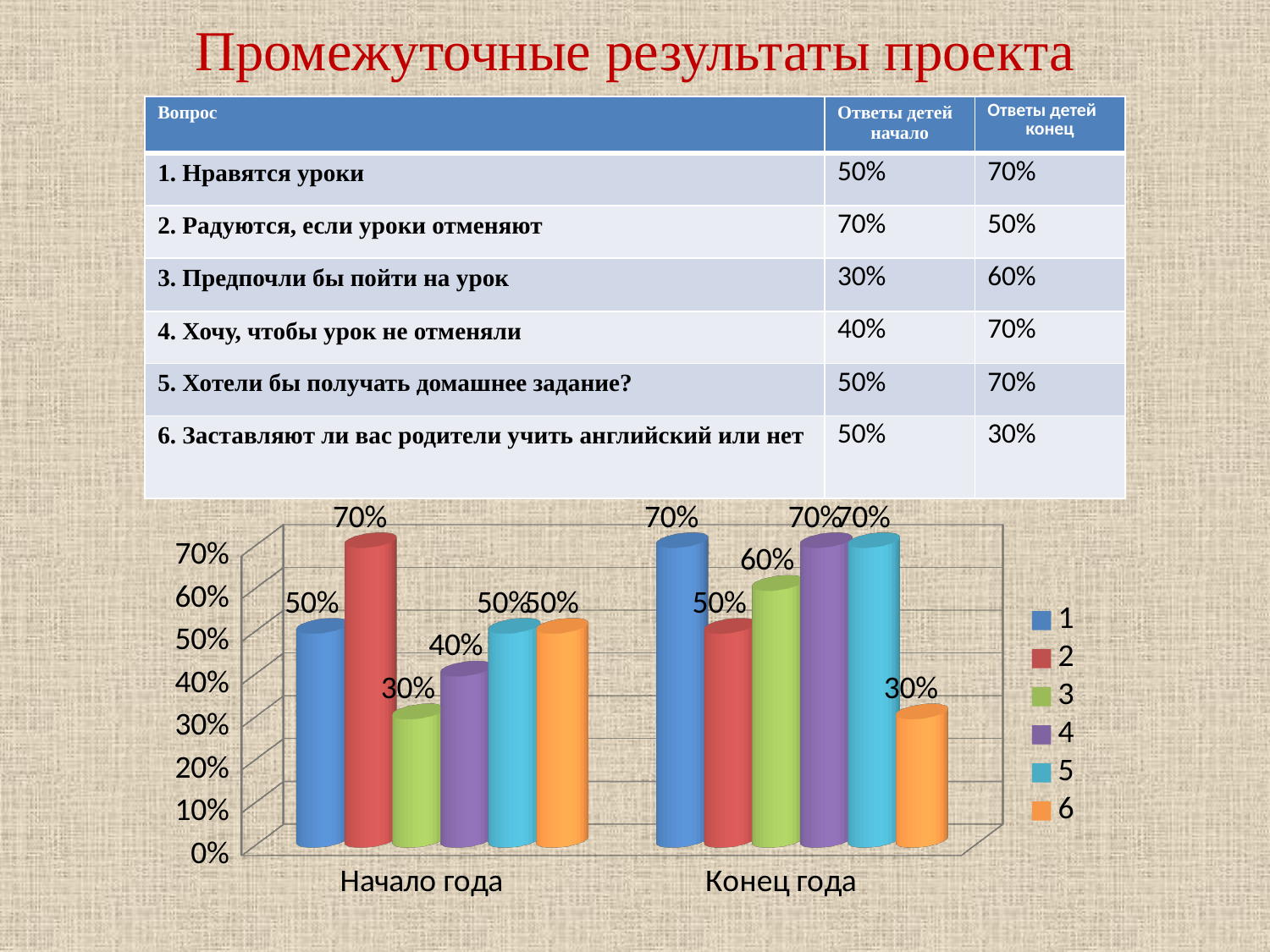
Which is larger: the value of series 1 for Начало года or for Конец года? Конец года What is the value of series 2 for Начало года? 70% What kind of chart is shown on the slide? bar chart What is the value of series 3 for Начало года? 30% What is the value of series 6 for Конец года? 30% Which series has the highest value for Начало года? 2 What is the difference between the value of series 4 for Конец года and for Начало года? 30% How many series does the chart legend list? 6 What are the two category labels on the x axis of the chart? Начало года, Конец года How many categories are shown on the x axis of the chart? 2 What is the value of series 3 for Конец года? 60% Which series has the lowest value for Конец года? 6